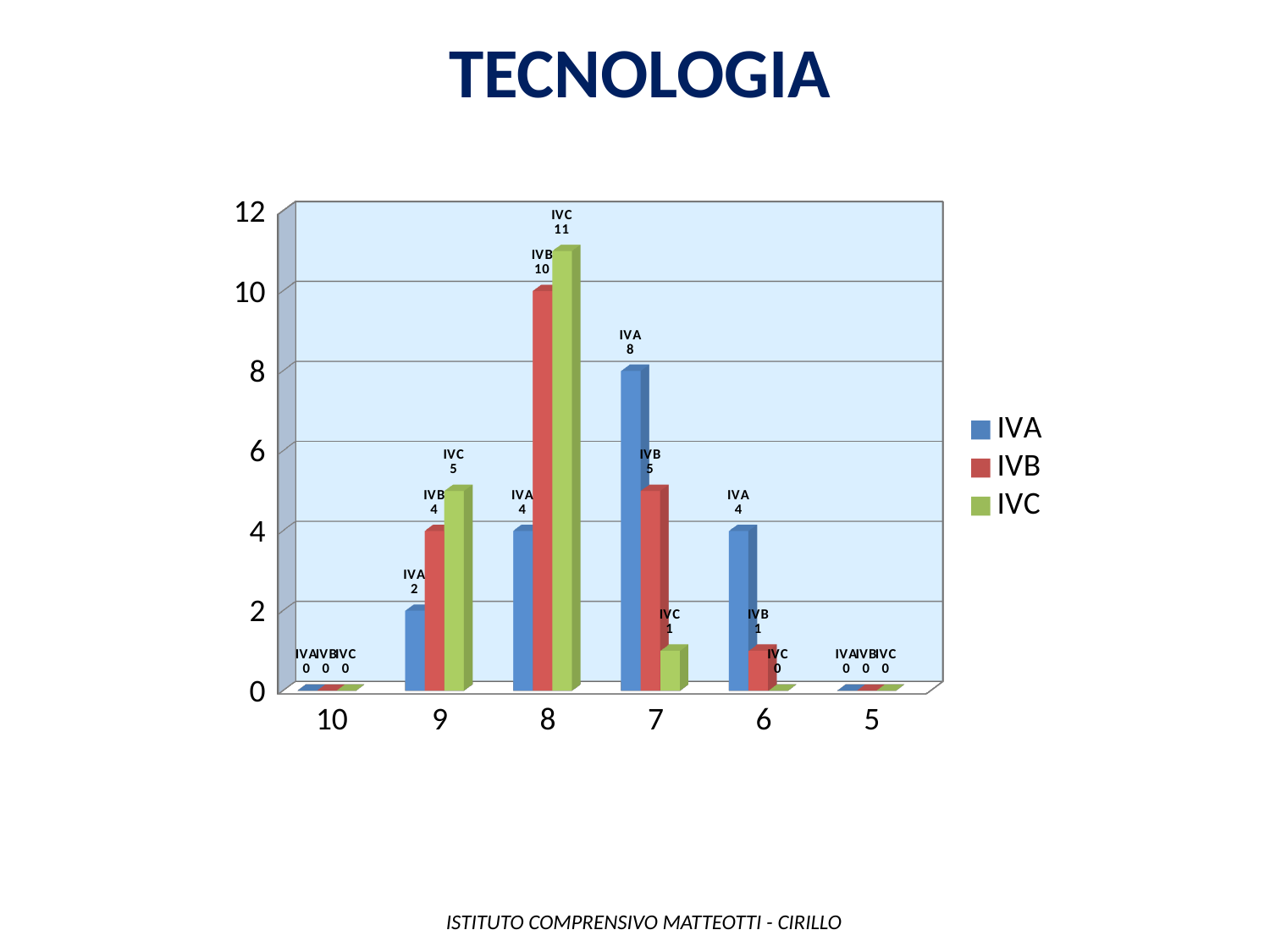
What kind of chart is shown on the slide? Bar chart How many series does the legend list? 3 What is the value for IVA at category 7? 8 How many categories are shown on the x axis? 6 At category 7, which series has the larger value, IVA or IVB? IVA Which category has the highest value for IVA? 7 Which category has the highest value for IVB? 8 What is the value for IVC at category 8? 11 What is the value for IVB at category 6? 1 What is the difference between the IVC and IVB values at category 8? 1 What is the difference between the IVA values at category 7 and category 9? 6 What is the value for IVB at category 9? 4